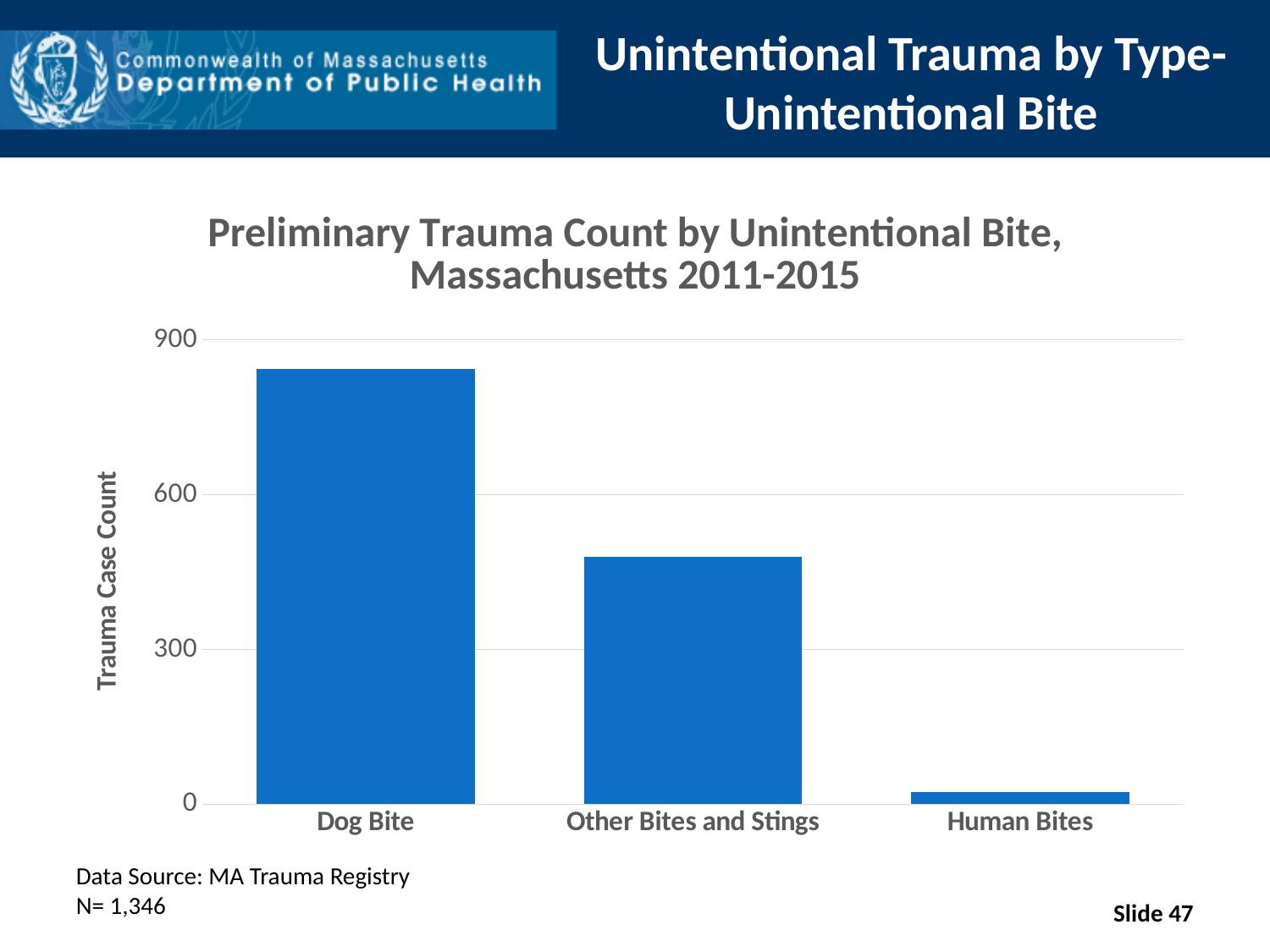
Which category has the lowest trauma case count? Human Bites What is the title of the chart? Preliminary Trauma Count by Unintentional Bite, Massachusetts 2011-2015 What type of chart is shown on the slide? bar chart Do the values rise or fall moving left to right along the x axis? fall Is the value for Other Bites and Stings greater or less than 300? greater Which is larger, the value for Dog Bite or the value for Other Bites and Stings? Dog Bite Is the value for Dog Bite greater or less than 600? greater How many categories are shown on the x axis? 3 Is the value for Other Bites and Stings greater or less than 600? less What is the label of the y axis? Trauma Case Count Which category has the highest trauma case count? Dog Bite